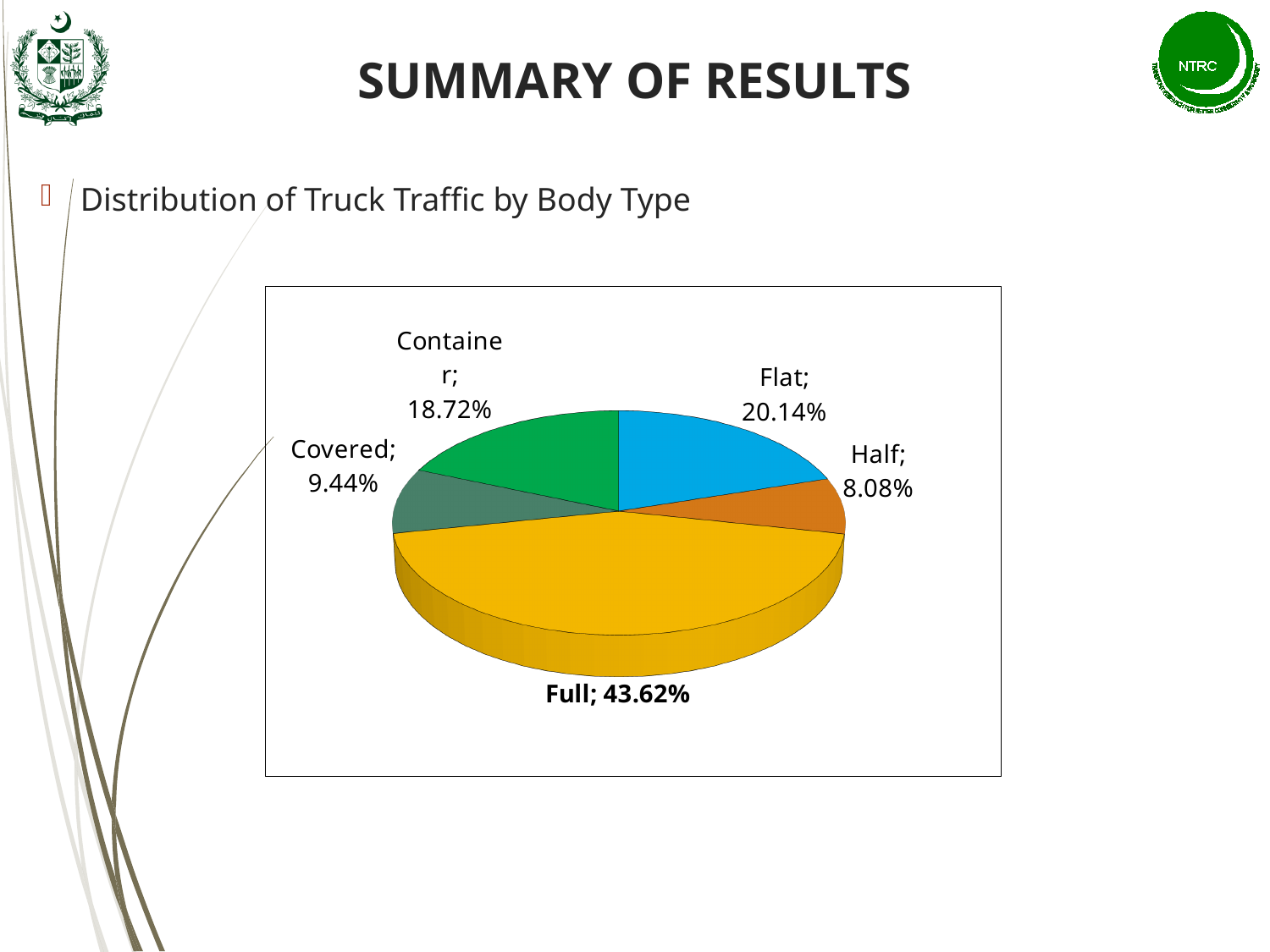
What is the difference in percentage points between the Full and Flat shares? 23.48 What share of truck traffic has a Full body type? 43.62% What share of truck traffic has a Covered body type? 9.44% What share of truck traffic has a Flat body type? 20.14% Which has a larger share of truck traffic, Flat or Container? Flat Which body type has the smallest share of truck traffic? Half What kind of chart is used to show the distribution of truck traffic by body type? Pie chart Which body type has the largest share of truck traffic? Full How many body type categories are shown in the pie chart? 5 What share of truck traffic has a Container body type? 18.72% What is the difference in percentage points between the Covered and Half shares? 1.36 What share of truck traffic has a Half body type? 8.08%